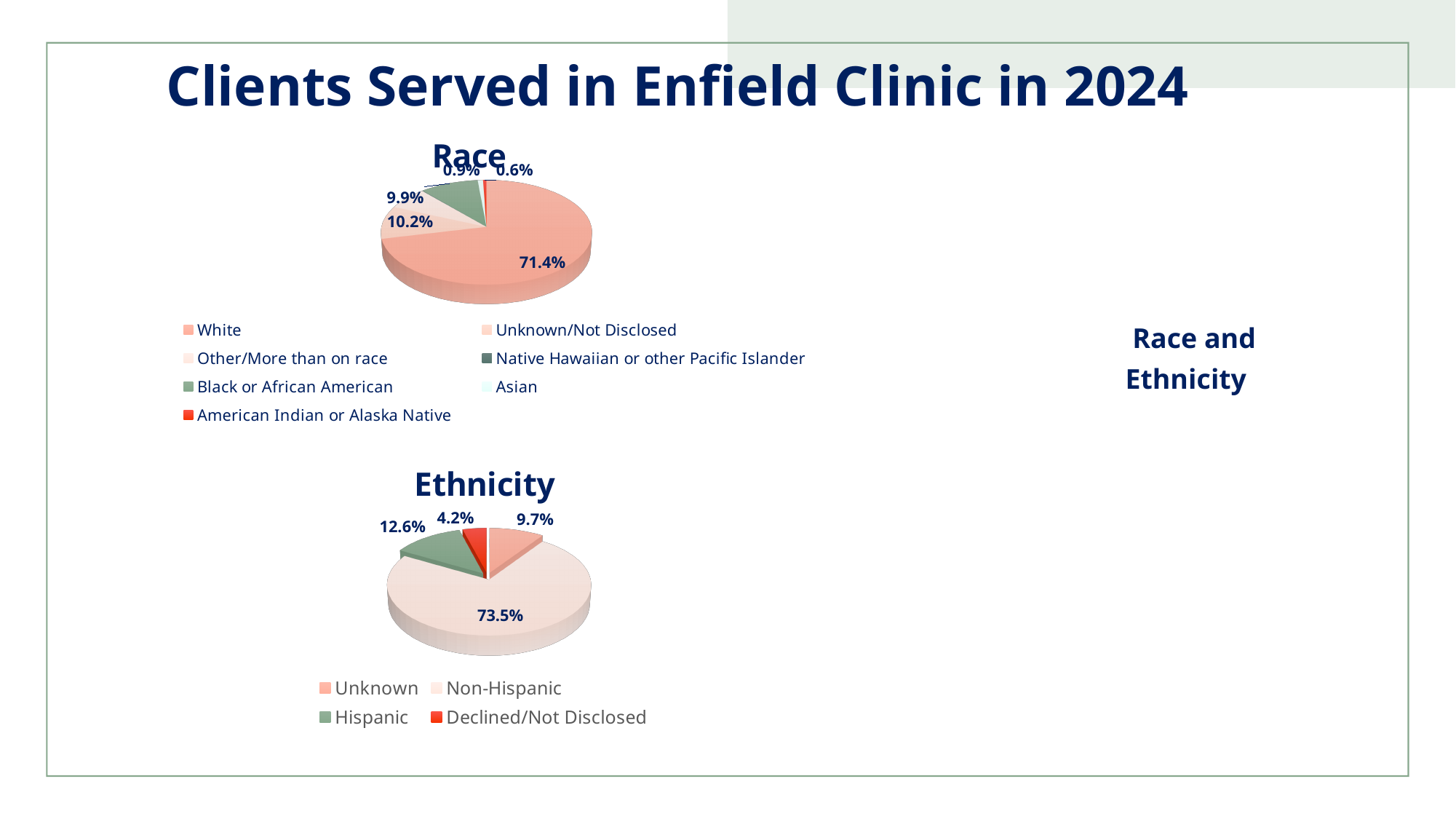
In the Ethnicity chart, which category has the smallest share? Declined/Not Disclosed How many categories does the legend of the Ethnicity chart list? 4 In the Ethnicity chart, what percentage of clients are Declined/Not Disclosed? 4.2% In the Race chart, which category has the largest share? White In the Ethnicity chart, which is larger: Hispanic or Unknown? Hispanic In the Race chart, what percentage of clients are White? 71.4% In the Ethnicity chart, what percentage of clients are Hispanic? 12.6% In the Ethnicity chart, what is the difference between the Hispanic and Unknown shares? 2.9% What kind of chart is the Race chart? pie chart How many entries does the legend of the Race chart list? 7 In the Ethnicity chart, what percentage of clients are Non-Hispanic? 73.5% In the Race chart, what percentage of clients are Black or African American? 9.9%